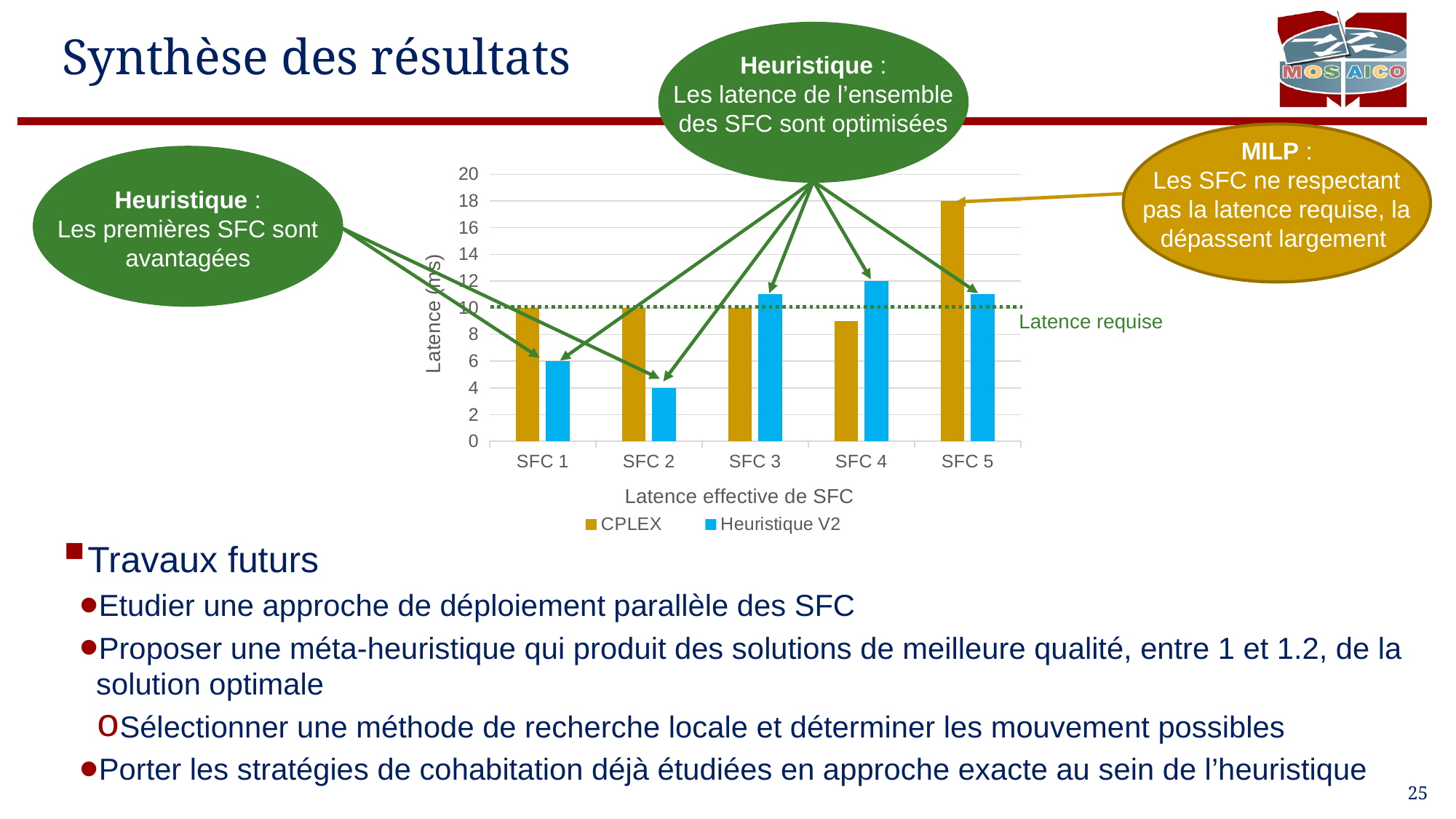
What is the title of the x axis of the chart? Latence effective de SFC What is the CPLEX latency for SFC 5? 18 For which SFC is the Heuristique V2 latency lowest? SFC 2 What is the Heuristique V2 latency for SFC 1? 6 For which SFC is the CPLEX latency highest? SFC 5 Which series are listed in the chart legend? CPLEX and Heuristique V2 How many SFC categories are shown on the x axis of the chart? 5 What kind of chart is shown on the slide? bar chart For SFC 1, which is larger: the CPLEX value or the Heuristique V2 value? CPLEX What is the Heuristique V2 latency for SFC 2? 4 How many series does the chart legend list? 2 Is the Heuristique V2 value for SFC 4 greater or less than 10? greater